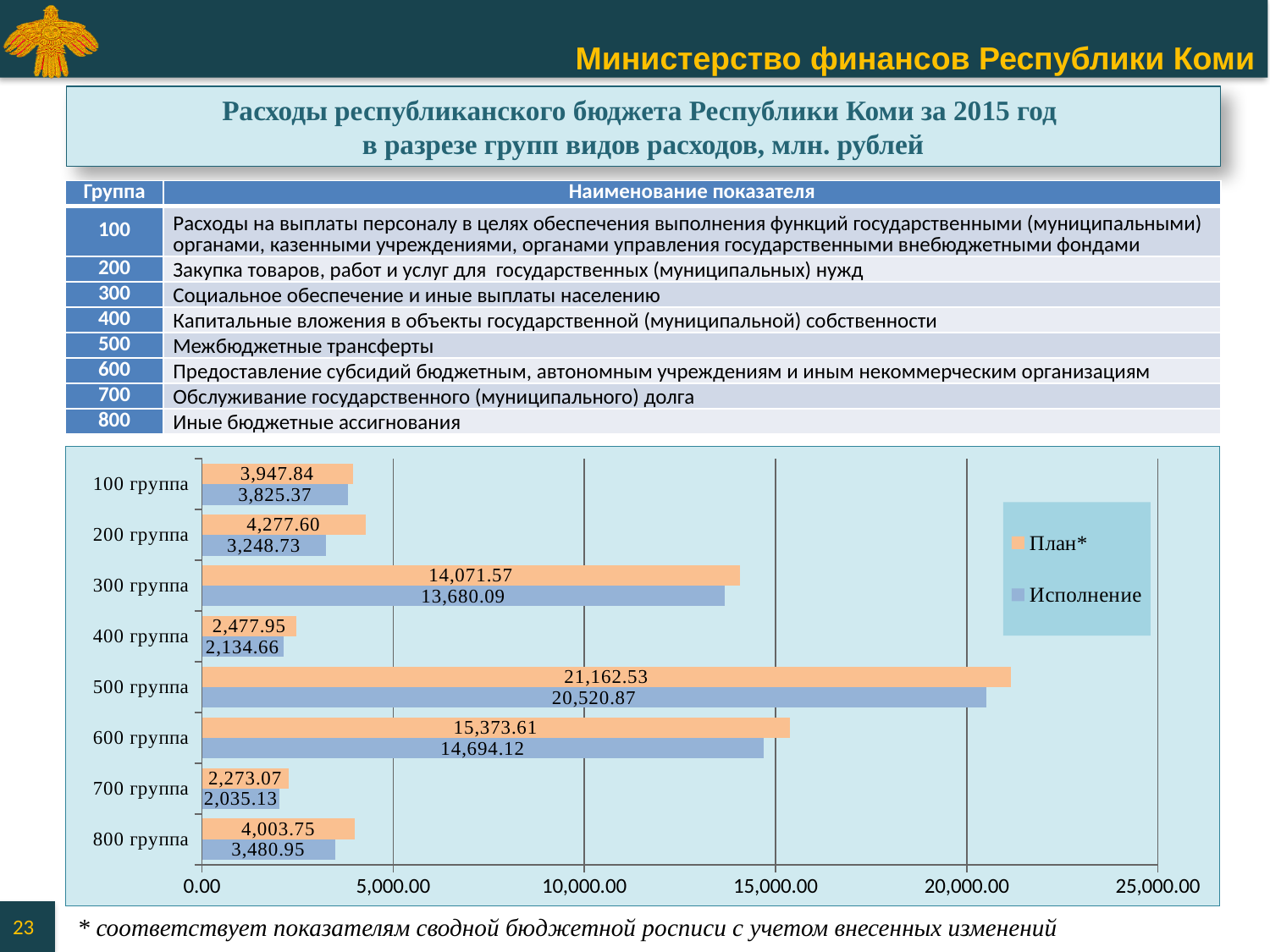
How many groups are shown on the chart? 8 What is the difference between the План* and Исполнение values for 100 группа? 122.47 What is the difference between the План* and Исполнение values for 500 группа? 641.66 Which group has the highest План* value? 500 группа Which group has the lowest Исполнение value? 700 группа What is the Исполнение value for 300 группа? 13,680.09 How many series does the chart legend list? 2 What kind of chart is shown on the slide? bar chart What is the Исполнение value for 700 группа? 2,035.13 Which is larger, the План* value for 200 группа or the План* value for 800 группа? 200 группа What is the План* value for 500 группа? 21,162.53 Is the Исполнение value for 600 группа greater or less than 10,000.00? greater